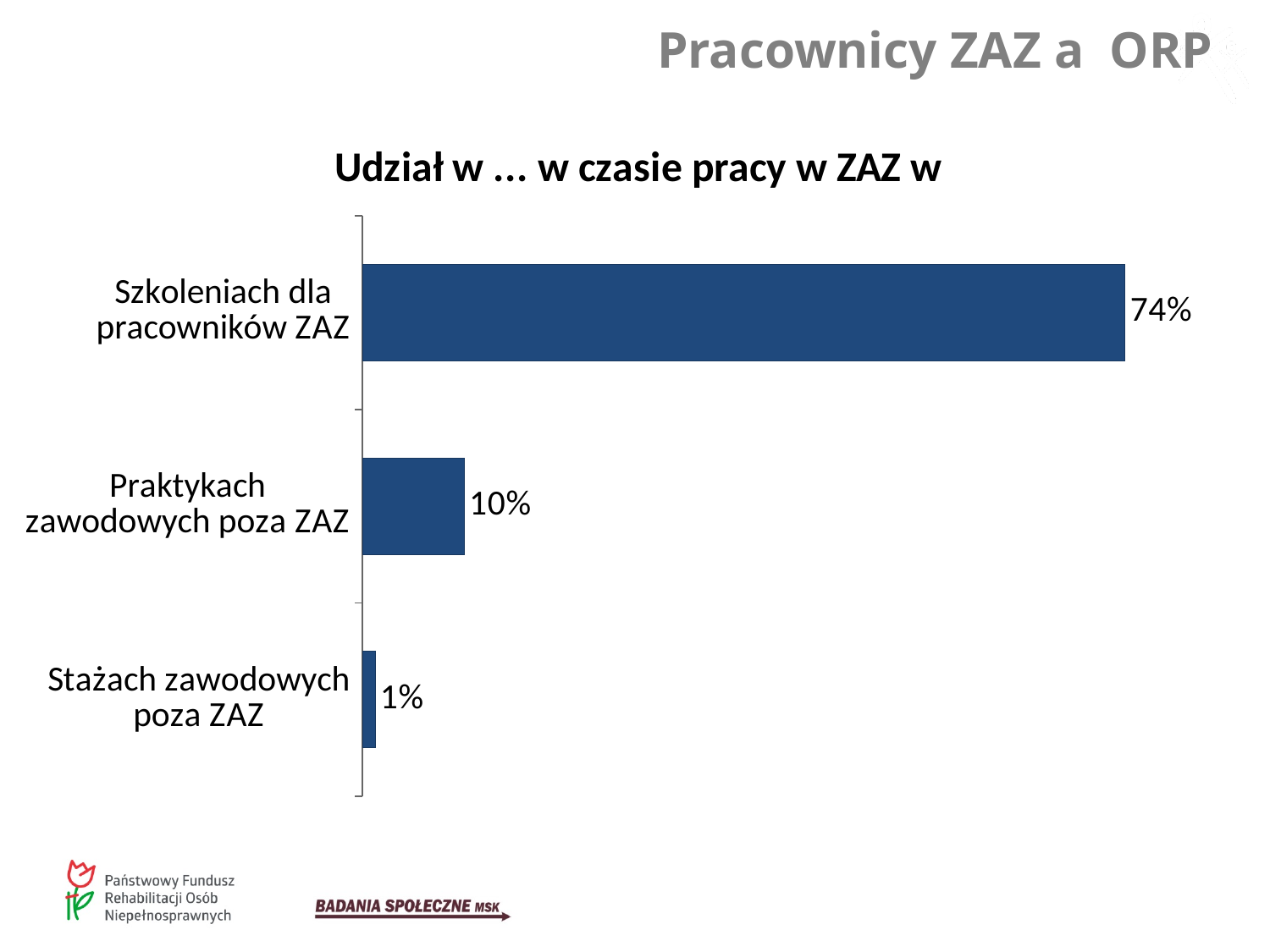
Which is larger: the value for 'Praktykach zawodowych poza ZAZ' or 'Stażach zawodowych poza ZAZ'? Praktykach zawodowych poza ZAZ Which category has the lowest value? Stażach zawodowych poza ZAZ What is the value for 'Stażach zawodowych poza ZAZ'? 1% What colour are the bars in the chart? Dark blue What is the difference between the values for 'Szkoleniach dla pracowników ZAZ' and 'Praktykach zawodowych poza ZAZ'? 64% What is the value for 'Szkoleniach dla pracowników ZAZ'? 74% What is the value for 'Praktykach zawodowych poza ZAZ'? 10% What is the title of the chart? Udział w … w czasie pracy w ZAZ w What kind of chart is shown on the slide? Bar chart What is the difference between the values for 'Praktykach zawodowych poza ZAZ' and 'Stażach zawodowych poza ZAZ'? 9% How many categories are shown in the chart? 3 Which category has the highest value? Szkoleniach dla pracowników ZAZ